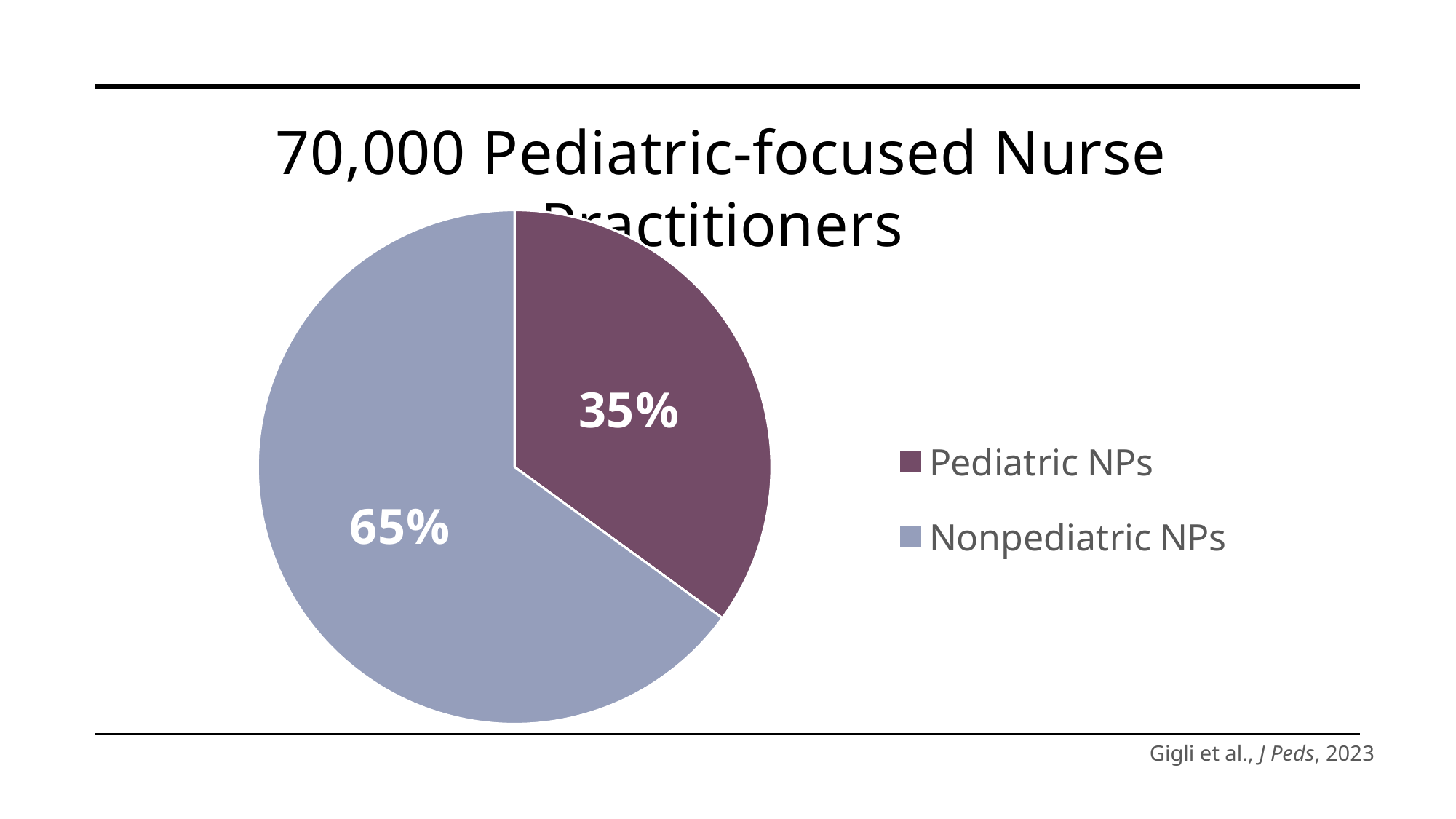
What is the difference in percentage points between the Nonpediatric NPs slice and the Pediatric NPs slice? 30 Which is larger: the Pediatric NPs slice or the Nonpediatric NPs slice? Nonpediatric NPs What percentage of the pie chart is Pediatric NPs? 35% How many entries does the legend list? 2 Which slice of the pie chart is the largest? Nonpediatric NPs What share of the pie does the Pediatric NPs slice represent? 35% What percentage of the pie chart is Nonpediatric NPs? 65% How many slices does the pie chart have? 2 Which slice of the pie chart is the smallest? Pediatric NPs Which legend entry is shown in the dark purple colour? Pediatric NPs What is the title of the chart? 70,000 Pediatric-focused Nurse Practitioners What kind of chart is shown on the slide? Pie chart